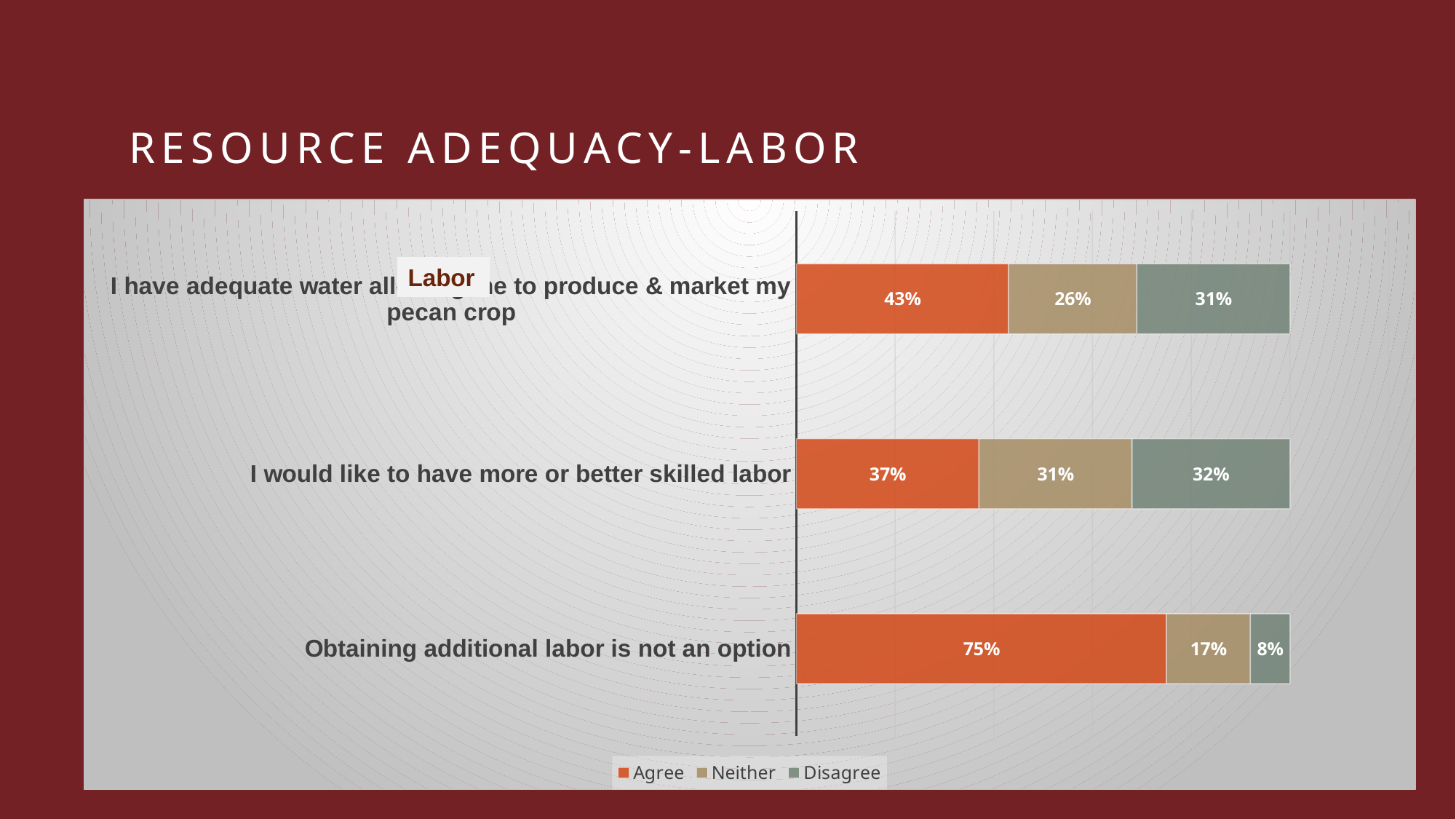
Which statement has the highest Agree percentage? Obtaining additional labor is not an option How many statements (categories) are shown in the chart? 3 What percentage agree with "Obtaining additional labor is not an option"? 75% What percentage disagree with "I would like to have more or better skilled labor"? 32% What is the difference between the Agree percentages for "Obtaining additional labor is not an option" and "I would like to have more or better skilled labor"? 38% What are the three legend entries of the chart? Agree, Neither, Disagree For "I would like to have more or better skilled labor", which is larger: the Agree share or the Neither share? Agree Which statement has the lowest Disagree percentage? Obtaining additional labor is not an option What type of chart is shown on the slide? Stacked bar chart What is the Neither value for the top bar, the statement about having adequate water to produce & market my pecan crop? 26% How many series does the legend list? 3 What is the Disagree value for "Obtaining additional labor is not an option"? 8%